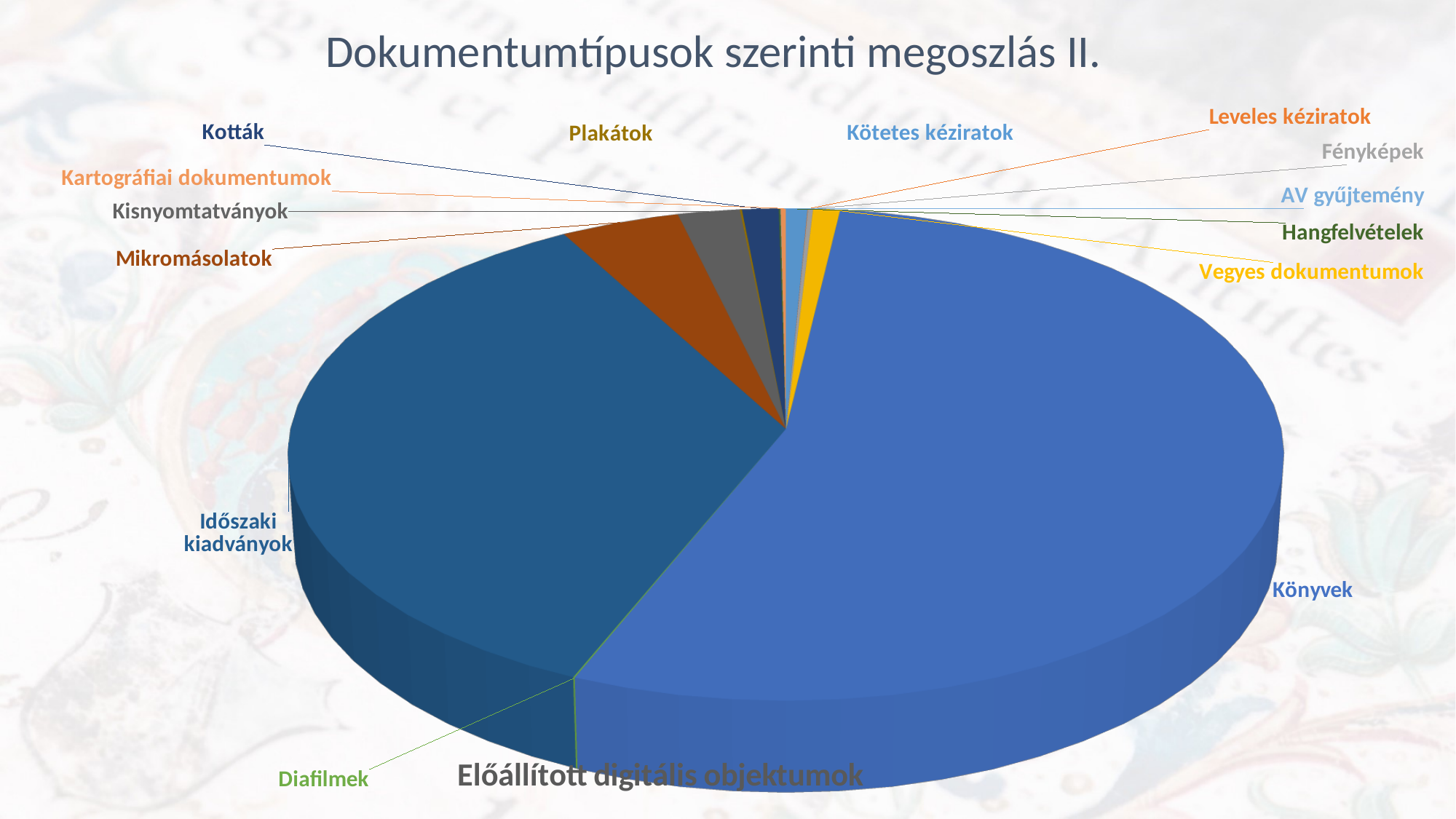
Which slice is larger, Könyvek or Időszaki kiadványok? Könyvek Which slice is larger, Vegyes dokumentumok or Hangfelvételek? Vegyes dokumentumok Which slice is larger, Mikromásolatok or Diafilmek? Mikromásolatok What colour is the Vegyes dokumentumok slice? yellow What kind of chart is shown on the slide? pie chart Which category has the second largest slice of the pie? Időszaki kiadványok Which category has the largest slice of the pie? Könyvek What is the title of the chart? Előállított digitális objektumok